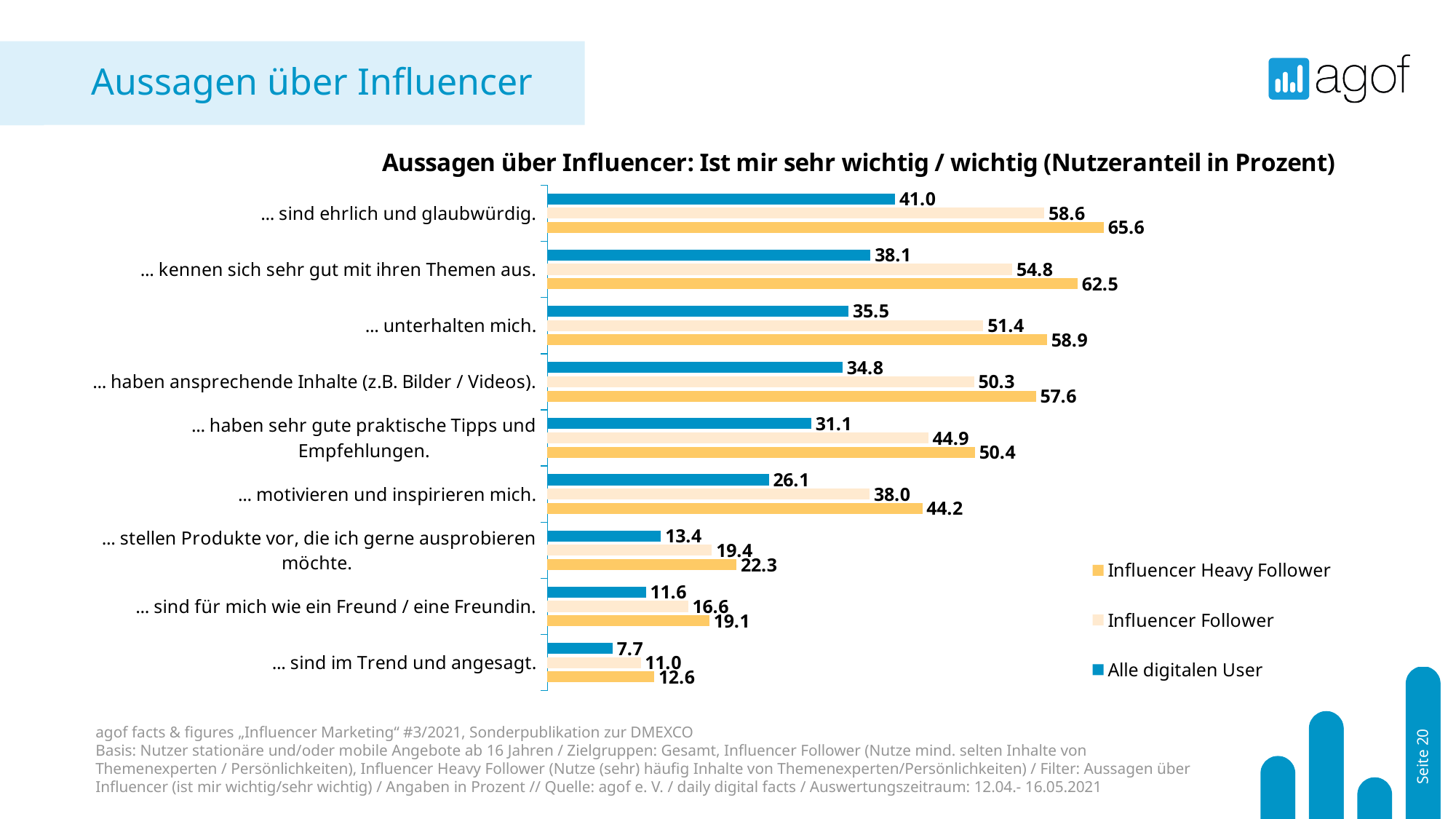
How many series does the legend list? 3 What is the title of the chart? Aussagen über Influencer: Ist mir sehr wichtig / wichtig (Nutzeranteil in Prozent) Which is larger for "… haben ansprechende Inhalte (z.B. Bilder / Videos).": the "Influencer Follower" value or the "Alle digitalen User" value? Influencer Follower What kind of chart is shown on the slide? Bar chart How many statements (categories) are shown in the chart? 9 Which statement has the highest value for "Influencer Heavy Follower"? … sind ehrlich und glaubwürdig. What is the difference between the "Influencer Heavy Follower" and "Alle digitalen User" values for "… kennen sich sehr gut mit ihren Themen aus."? 24.4 What is the value for "Influencer Follower" for "… motivieren und inspirieren mich."? 38.0 What is the value for "Influencer Heavy Follower" for "… unterhalten mich."? 58.9 Which series is shown in dark blue in the legend? Alle digitalen User Which statement has the lowest value for "Alle digitalen User"? … sind im Trend und angesagt. What is the value for "Alle digitalen User" for "… sind ehrlich und glaubwürdig."? 41.0